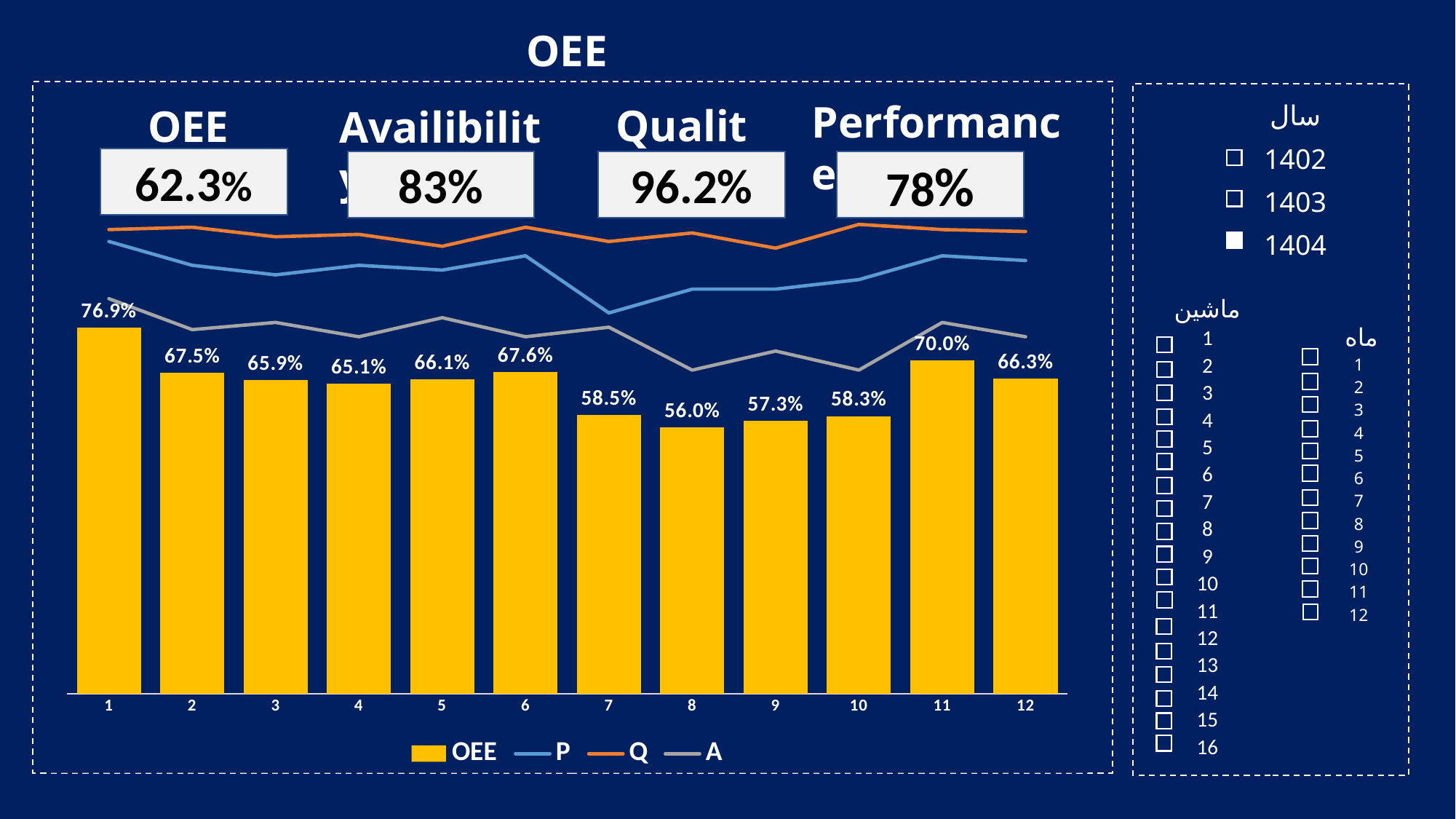
What is the difference between the OEE values for month 1 and month 8? 20.9 percentage points How many months are shown on the x axis of the chart? 12 What kind of chart is shown on the slide? A combined bar and line chart Do the OEE bars rise or fall from month 6 to month 8? Fall What is the OEE value for month 1? 76.9% Which month has a higher OEE value, month 5 or month 9? Month 5 How many series does the chart legend list? 4 Which month has the lowest OEE bar? 8 What is the OEE value for month 11? 70.0% What is the OEE value for month 8? 56.0% What is the difference between the OEE values for month 11 and month 10? 11.7 percentage points Which month has the highest OEE bar? 1